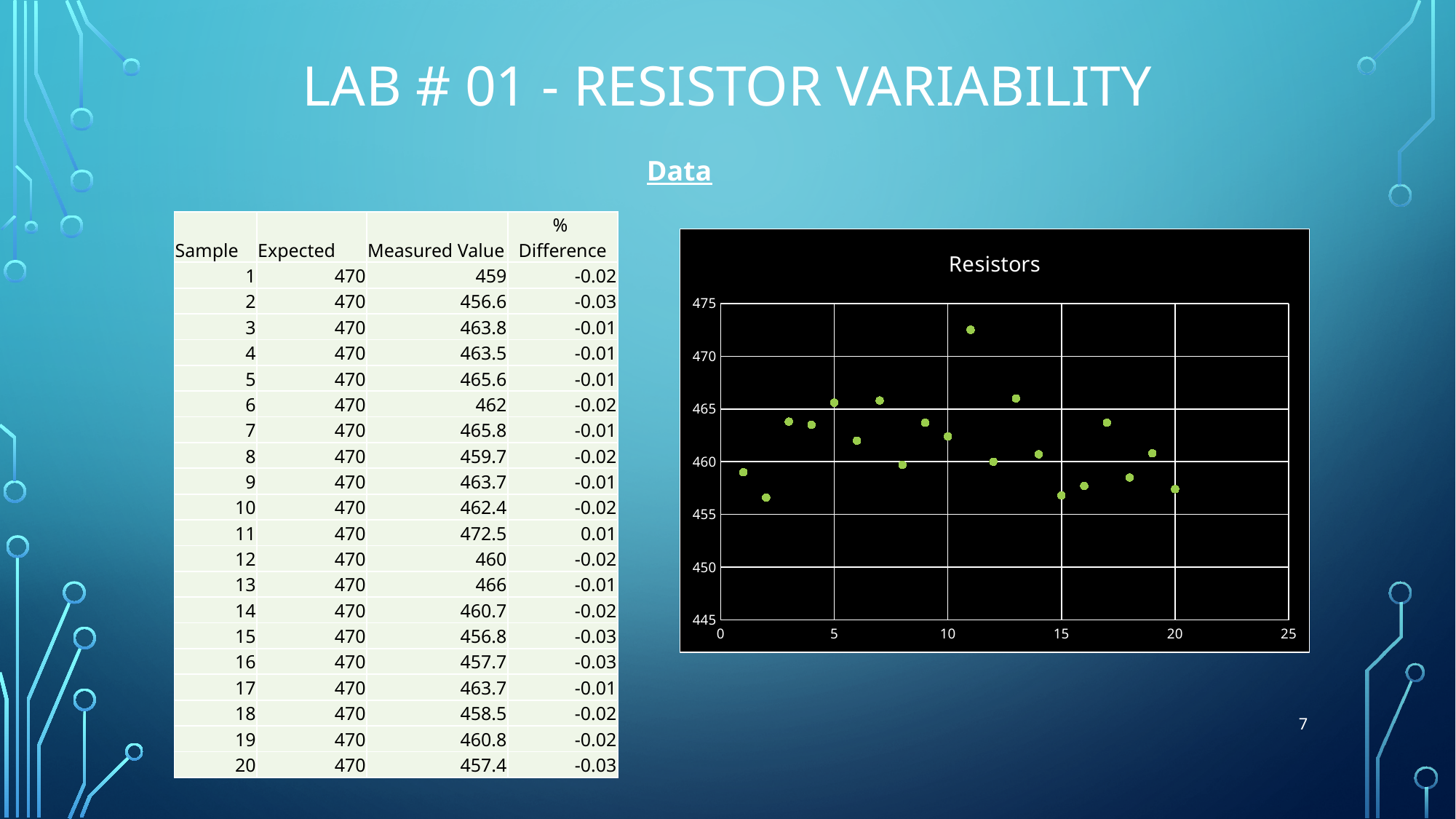
What is the highest value shown on the y axis of the "Resistors" chart? 475 In the "Resistors" chart, which has the larger value, sample 13 or sample 20? sample 13 How many data points are plotted in the "Resistors" chart? 20 In the "Resistors" chart, which sample number has the highest plotted value? 11 In the "Resistors" chart, is the value for sample 3 greater or less than 460? greater What is the title of the chart on the slide? Resistors According to the table, what is the measured value plotted for sample 11 in the "Resistors" chart? 472.5 In the "Resistors" chart, which has the larger value, sample 11 or sample 2? sample 11 In the "Resistors" chart, is the value for sample 2 greater or less than 460? less What kind of chart is the "Resistors" chart? scatter chart In the "Resistors" chart, is the value for sample 11 greater or less than 470? greater